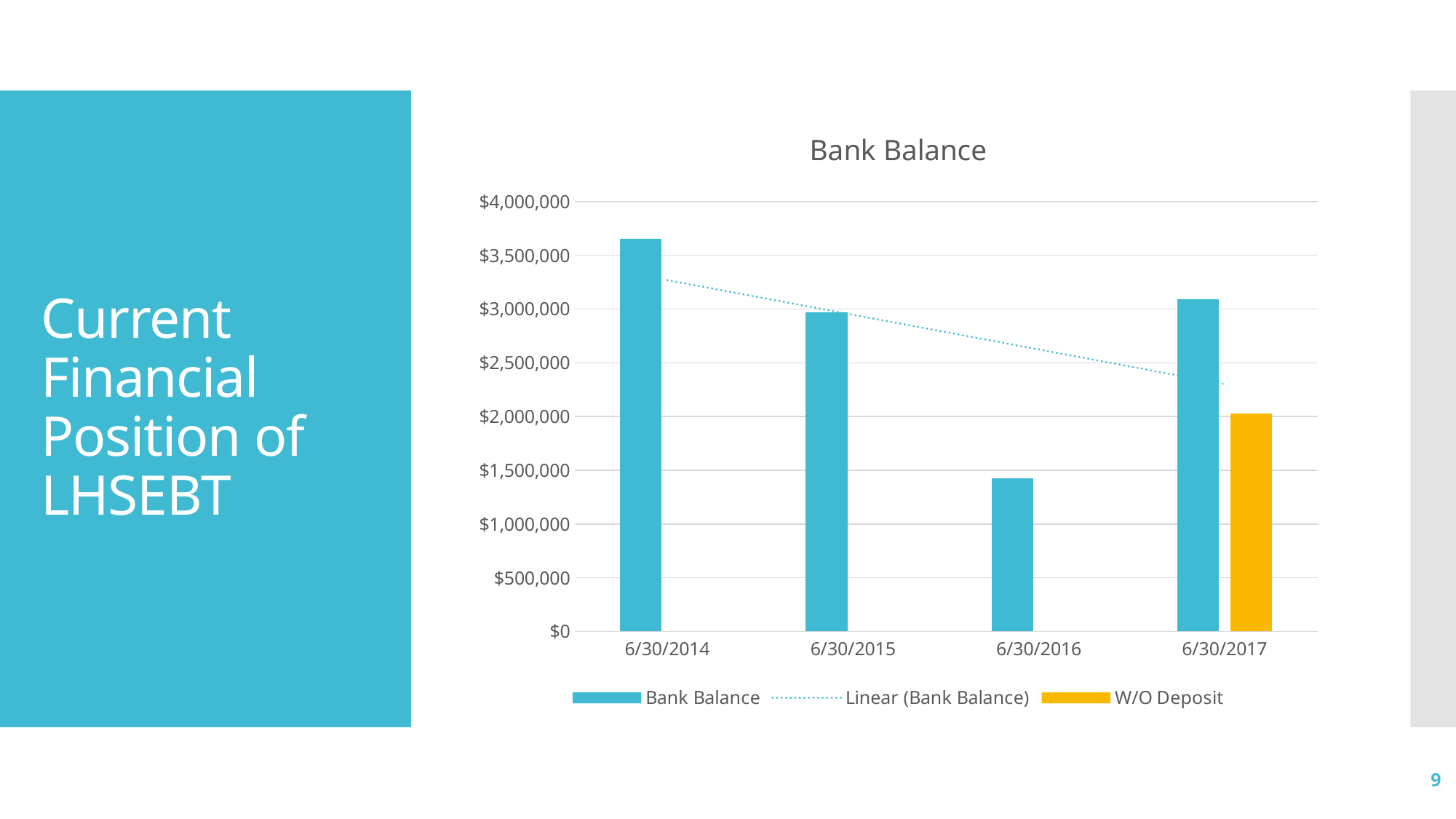
Does the dotted Linear (Bank Balance) trendline rise or fall from left to right? fall Which is larger, the Bank Balance for 6/30/2014 or for 6/30/2017? 6/30/2014 Is the Bank Balance for 6/30/2014 greater or less than $3,500,000? greater On which date is the Bank Balance bar lowest? 6/30/2016 Which is larger, the Bank Balance for 6/30/2016 or the W/O Deposit bar for 6/30/2017? W/O Deposit for 6/30/2017 How many entries does the chart legend list? 3 How many dates are shown on the x axis of the chart? 4 What is the title of the chart? Bank Balance What colour is the W/O Deposit bar? yellow/orange On which date is the Bank Balance bar highest? 6/30/2014 Is the Bank Balance for 6/30/2016 greater or less than $1,500,000? less What kind of chart is shown on the slide? bar chart